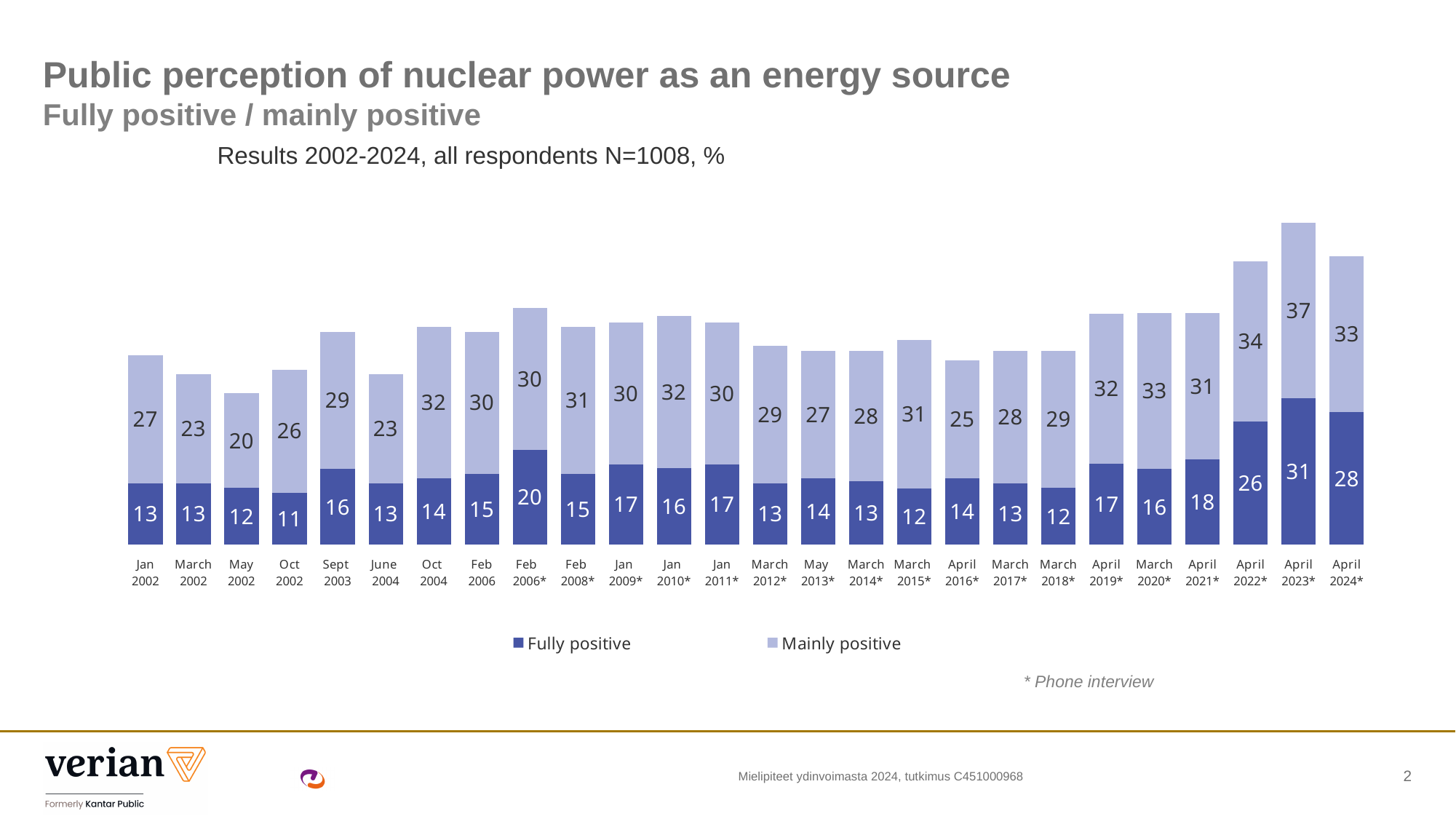
How many survey dates (bars) are plotted in the chart? 26 What is the Fully positive value for April 2024*? 28 Which survey date has the lowest Mainly positive value? May 2002 What does the asterisk (*) after a survey date indicate, according to the note on the slide? Phone interview What is the Mainly positive value for Sept 2003? 29 Which survey date has the lowest Fully positive value? Oct 2002 What is the total of the stacked bar for April 2023*? 68 Which survey date has the highest Fully positive value? April 2023* What is the difference between the Fully positive values for April 2023* and April 2024*? 3 Which is larger, the Mainly positive value for Oct 2004 or for Feb 2006? Oct 2004 What kind of chart is shown on the slide? Stacked bar chart How many series does the legend list? 2